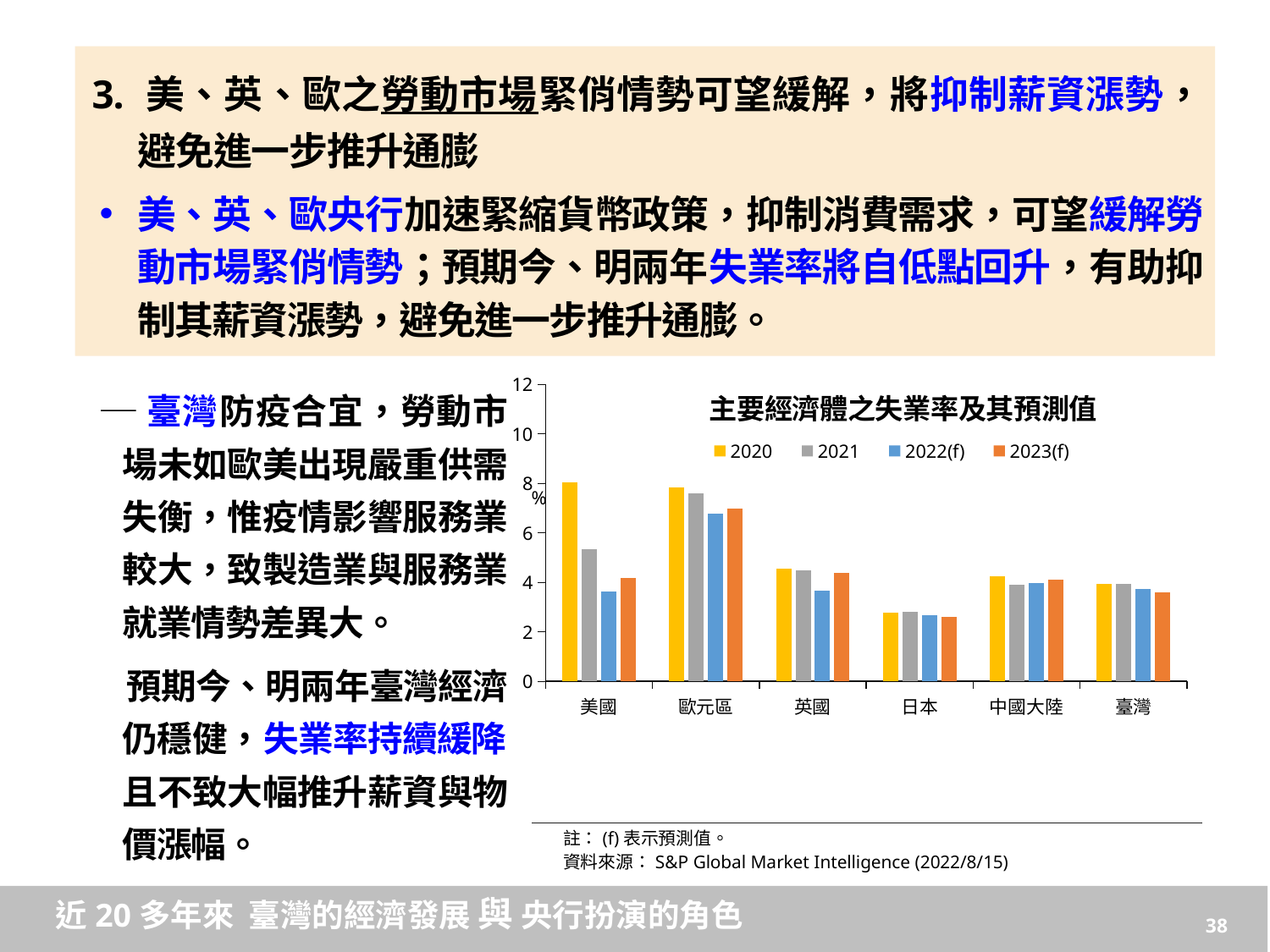
Is the 2022(f) value for 歐元區 greater or less than 6? greater What is the title of the chart? 主要經濟體之失業率及其預測值 Is the 2021 value for 美國 greater or less than 4? greater Which economy has the highest 2022(f) unemployment rate in the chart? 歐元區 Does the unemployment rate for 美國 rise or fall from 2020 to 2022(f)? fall How many economies (categories) are shown on the x axis of the chart? 6 How many series does the chart legend list? 4 Is the 2020 value for 美國 greater or less than 6? greater For 美國, which is larger: the 2020 value or the 2021 value? 2020 What kind of chart is shown on the slide? bar chart Which economy has the lowest 2020 unemployment rate in the chart? 日本